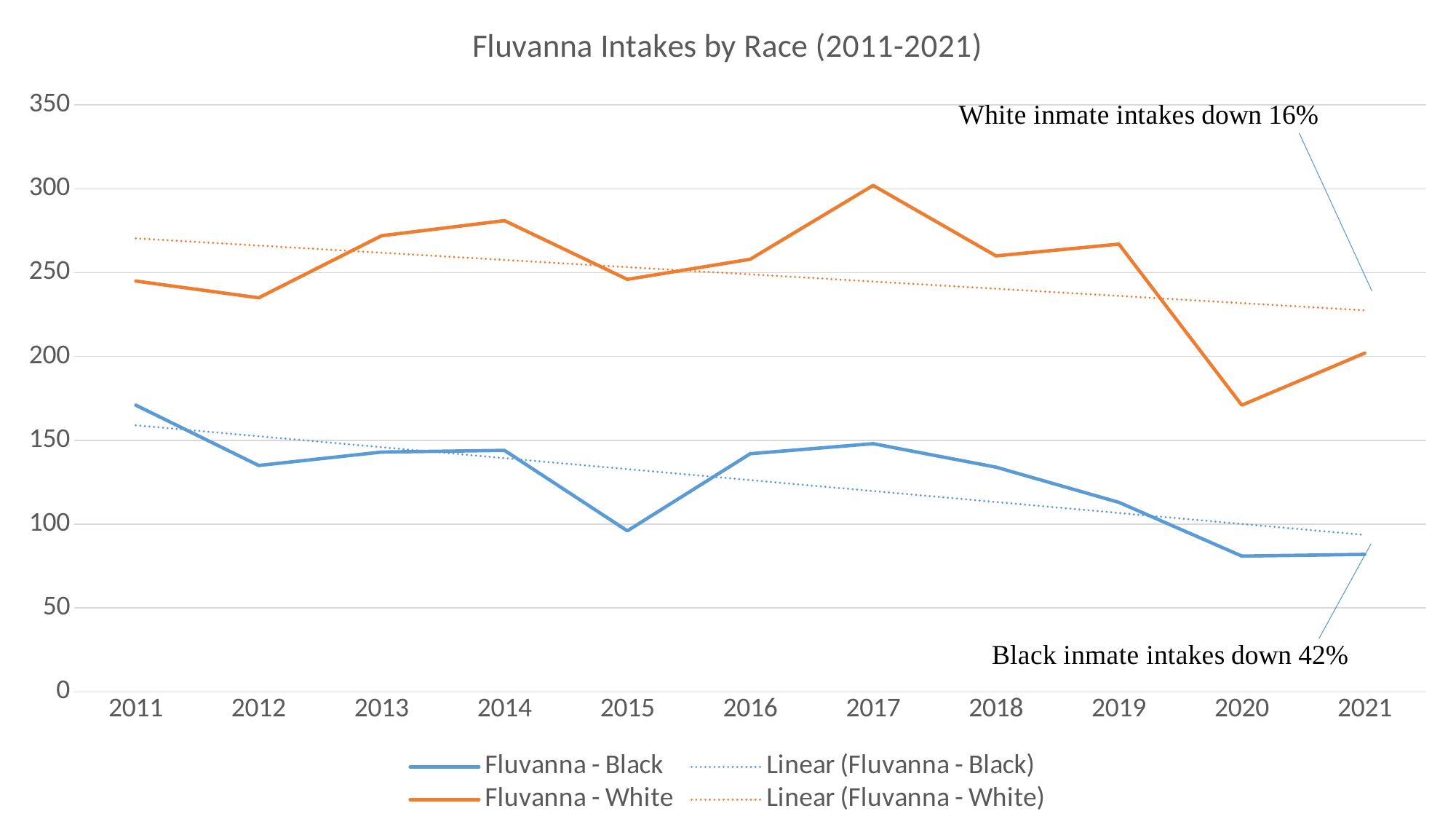
Is the Fluvanna - Black value for 2011 greater or less than 150? greater In which year is the Fluvanna - White series highest? 2017 According to the annotation on the chart, by what percentage are Black inmate intakes down? 42% What kind of chart is shown on the slide? line chart Is the Fluvanna - White value for 2020 greater or less than 200? less What is the title of the chart? Fluvanna Intakes by Race (2011-2021) Is the Fluvanna - White value for 2014 greater or less than 250? greater How many years are shown on the x axis? 11 In which year is the Fluvanna - White series lowest? 2020 In which year is the Fluvanna - Black series highest? 2011 How many entries does the legend list? 4 Which series has the larger value in 2015, Fluvanna - Black or Fluvanna - White? Fluvanna - White